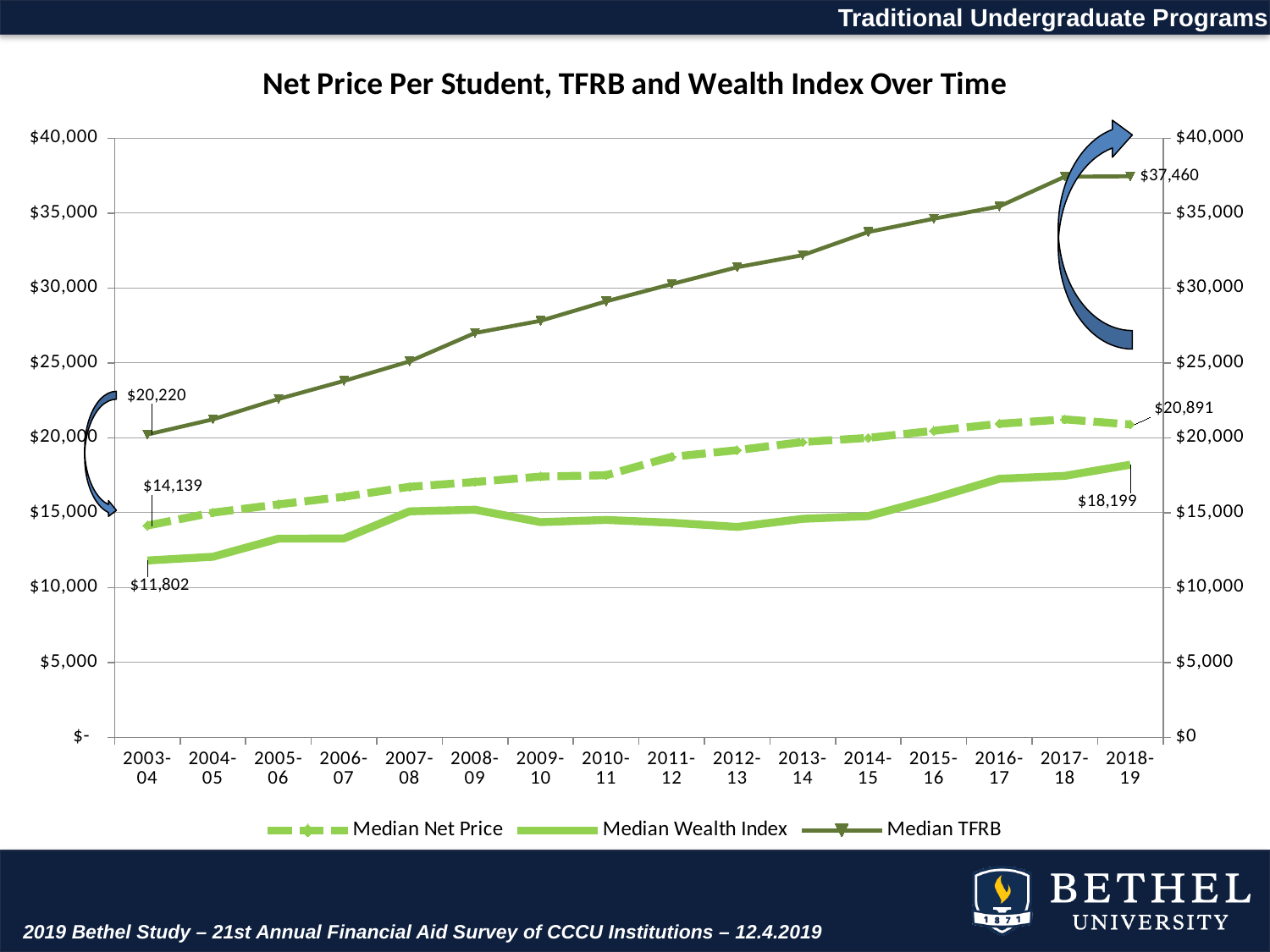
What is the Median TFRB value for 2018-19? $37,460 How many series does the legend list? 3 By how much did the Median TFRB increase from 2003-04 to 2018-19? $17,240 What is the Median TFRB value for 2003-04? $20,220 What is the Median Net Price for 2018-19? $20,891 Is the Median Wealth Index for 2012-13 greater or less than $15,000? less What is the Median Net Price for 2003-04? $14,139 By how much did the Median Net Price increase from 2003-04 to 2018-19? $6,752 Does the Median TFRB rise or fall from 2003-04 to 2018-19? Rises What is the Median Wealth Index for 2018-19? $18,199 What is the Median Wealth Index for 2003-04? $11,802 What kind of chart is shown on the slide? Line chart